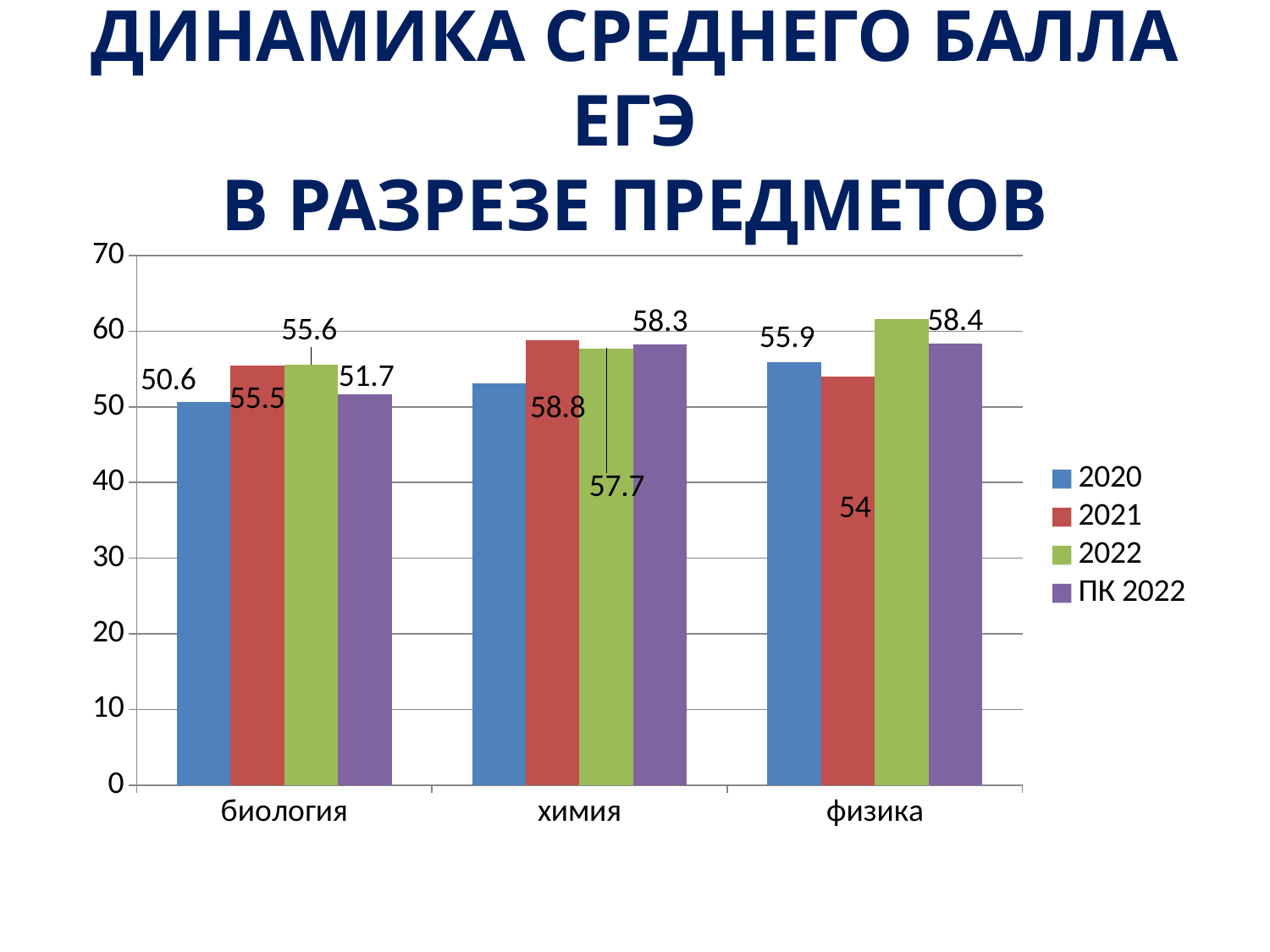
Which series has the highest value in the физика category? 2022 What is the value for 2020 in the биология category? 50.6 Is the value for 2022 in the физика category greater or less than 60? greater What kind of chart is shown on the slide? bar chart What is the value for 2021 in the физика category? 54 Which has the larger 2020 value, биология or физика? физика How many series does the legend list? 4 What is the value for 2021 in the химия category? 58.8 What is the value for ПК 2022 in the биология category? 51.7 What is the difference between the 2021 and 2020 values for биология? 4.9 What is the value for 2020 in the физика category? 55.9 How many subject categories are shown on the x axis? 3